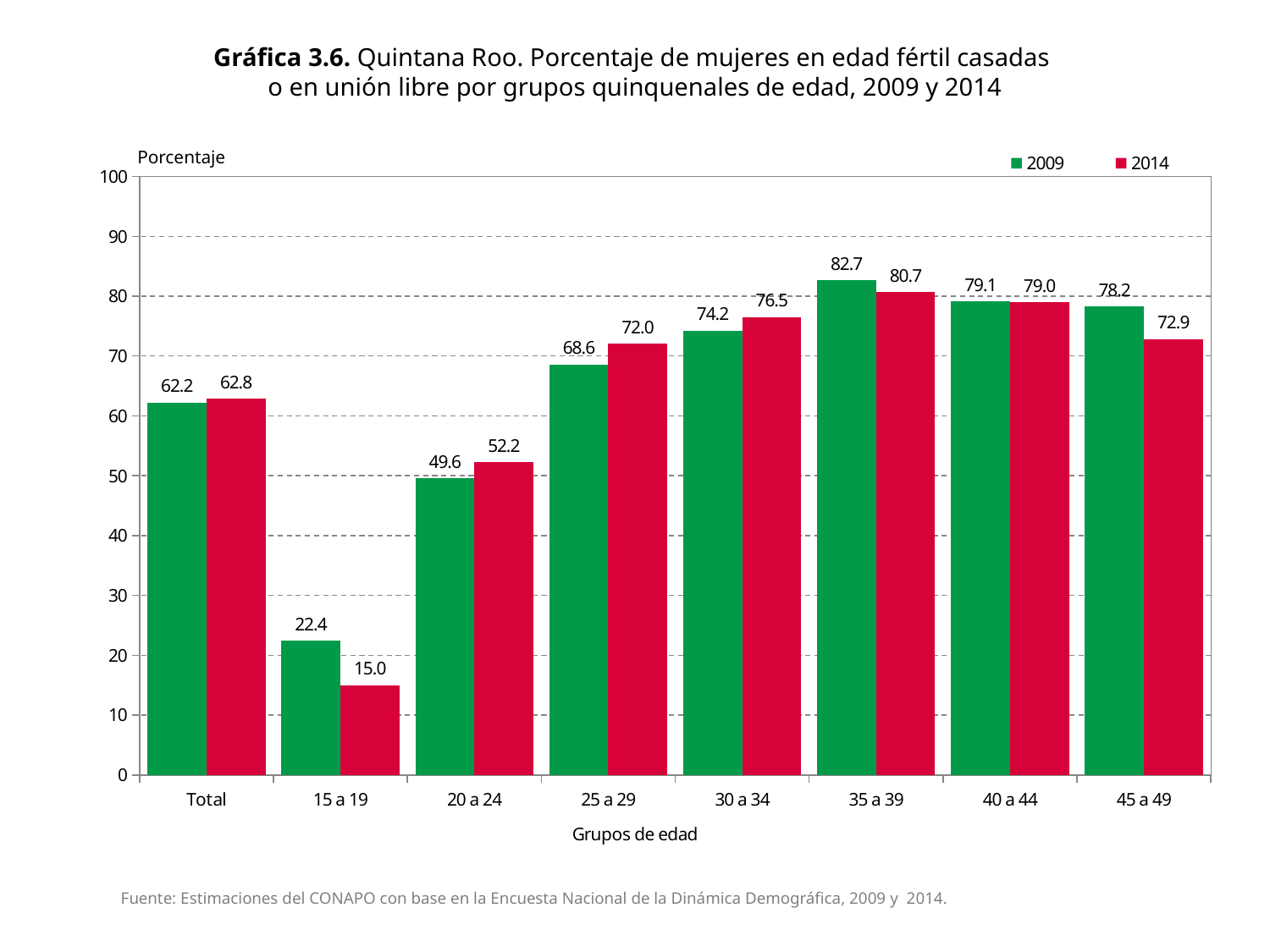
Which is larger for the 30 a 34 age group, the 2009 value or the 2014 value? 2014 What kind of chart is shown on the slide? Bar chart What is the value for the 35 a 39 age group in 2014? 80.7 What is the value for the 15 a 19 age group in 2009? 22.4 What is the difference between the 2014 and 2009 values for the 20 a 24 age group? 2.6 Which age group has the highest value in 2009? 35 a 39 What is the difference between the 2009 and 2014 values for the 45 a 49 age group? 5.3 How many age-group categories are shown on the x axis, including Total? 8 Which age group has the lowest value in 2014? 15 a 19 Which colour represents the 2014 series? Red How many series does the legend list? 2 What is the Total value for 2014? 62.8